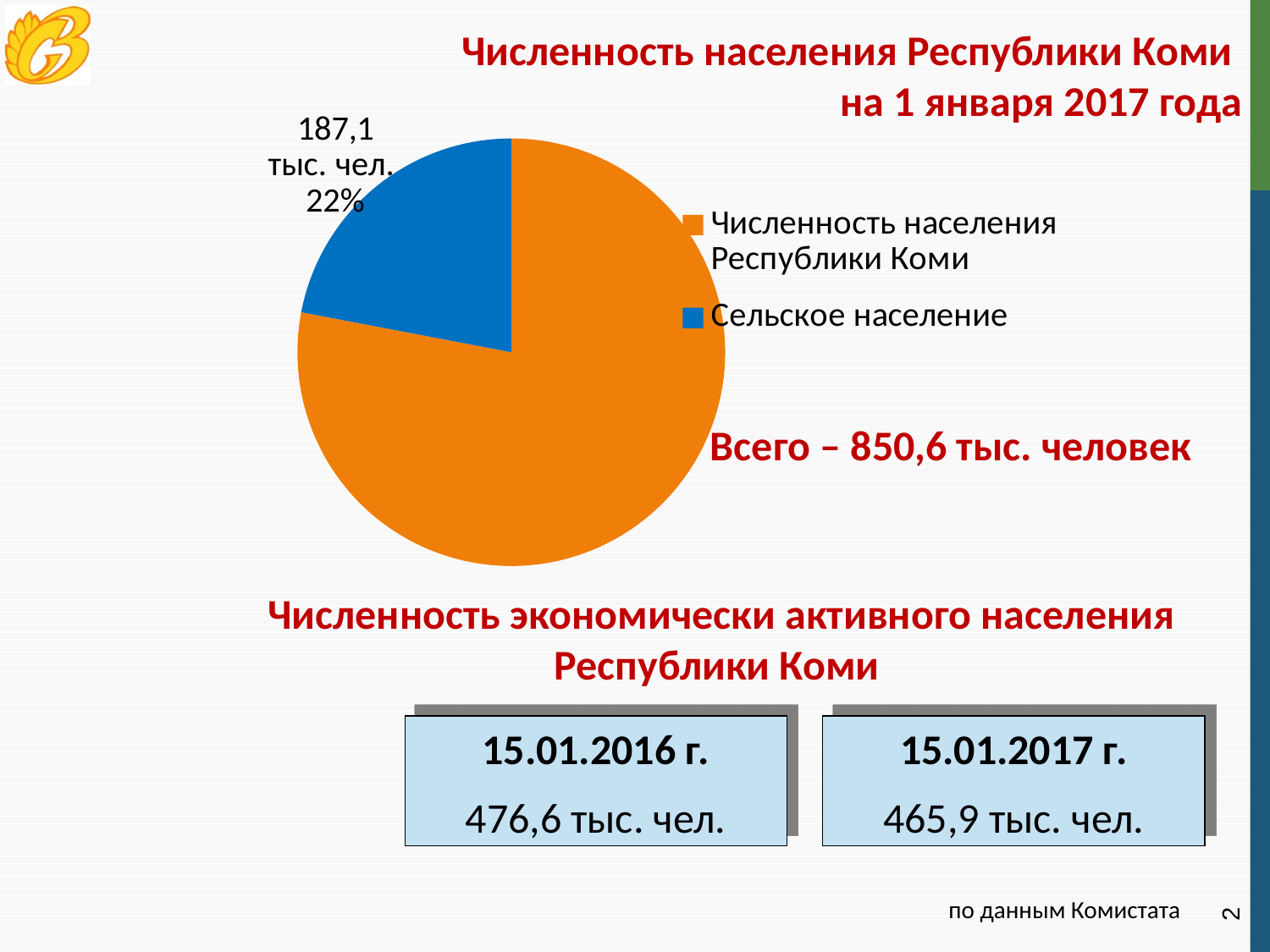
What value is printed on the slice for Сельское население? 187,1 тыс. чел. Which slice is larger: Численность населения Республики Коми or Сельское население? Численность населения Республики Коми Which legend entry corresponds to the largest slice of the pie? Численность населения Республики Коми Which legend entry corresponds to the smallest slice of the pie? Сельское население How many entries does the legend of the pie chart list? 2 How many slices does the pie chart have? 2 What colour is the Сельское население slice in the pie chart? blue What total population is stated next to the pie chart? 850,6 тыс. человек What kind of chart is shown on the slide? pie chart What share of the pie does the Сельское население slice represent? 22%